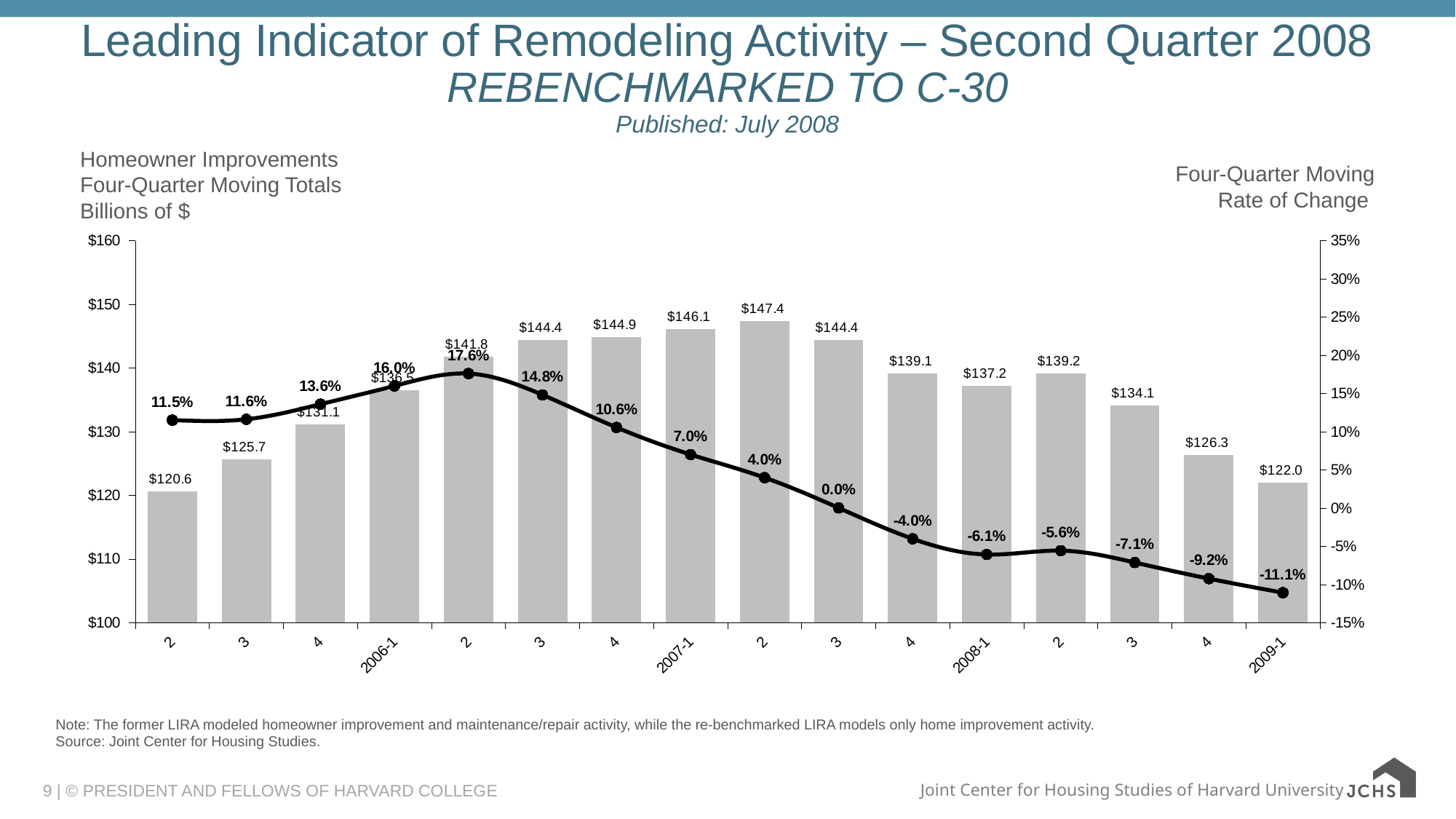
What is the label of the right-hand axis? Four-Quarter Moving Rate of Change What is the four-quarter moving total for 2007-1? $146.1 What is the four-quarter moving total for 2009-1? $122.0 What is the four-quarter moving rate of change for 2006-1? 16.0% What is the four-quarter moving rate of change for 2008-1? -6.1% What is the lowest four-quarter moving rate of change shown on the line? -11.1% How many quarters are plotted along the x axis? 16 Does the four-quarter moving rate of change line rise or fall from 2007-1 to 2009-1? Fall What kind of chart is this? Combined bar and line chart What is the difference between the four-quarter moving totals for 2008-1 and 2009-1? $15.2 Which has the larger four-quarter moving total, 2007-1 or 2008-1? 2007-1 What is the highest four-quarter moving total shown by the bars? $147.4